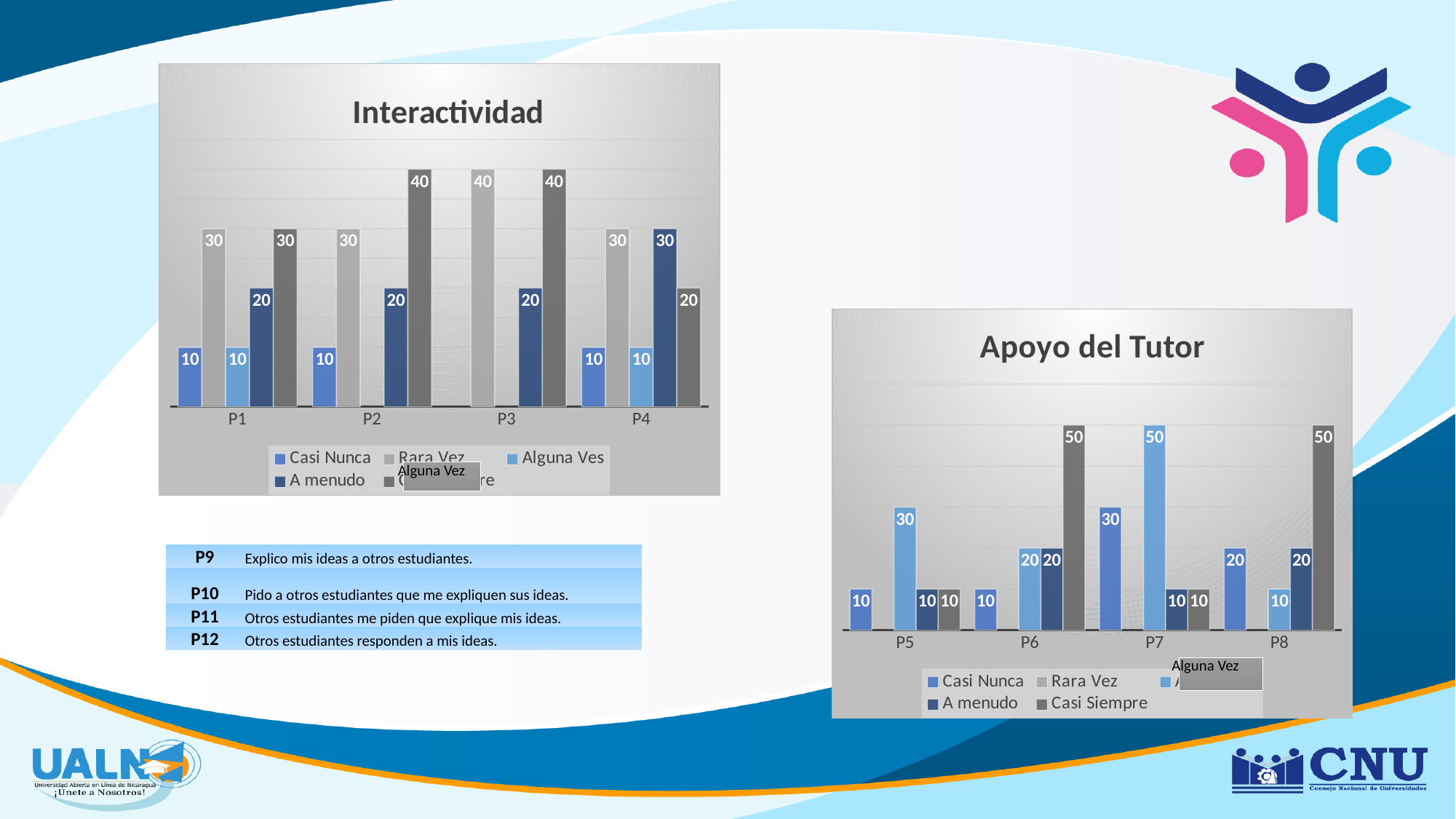
In the Interactividad chart, what is the value of Casi Siempre for P2? 40 In the Apoyo del Tutor chart, is Casi Nunca for P7 larger or smaller than Casi Nunca for P8? larger In the Interactividad chart, what is the value of A menudo for P4? 30 In the Interactividad chart, how many categories are shown on the x axis? 4 In the Apoyo del Tutor chart, what is the value of Casi Siempre for P6? 50 In the Apoyo del Tutor chart, what is the value of Alguna Vez for P7? 50 In the Apoyo del Tutor chart, what is the difference between Casi Siempre and Casi Nunca for P8? 30 In the Interactividad chart, which series has the highest value for P1? Rara Vez and Casi Siempre (both 30) In the Interactividad chart, what is the difference between Casi Siempre and A menudo for P2? 20 In the Interactividad chart, what is the value of Rara Vez for P3? 40 How many series does the legend of the Apoyo del Tutor chart list? 5 In the Apoyo del Tutor chart, which series has the highest value for P5? Alguna Vez